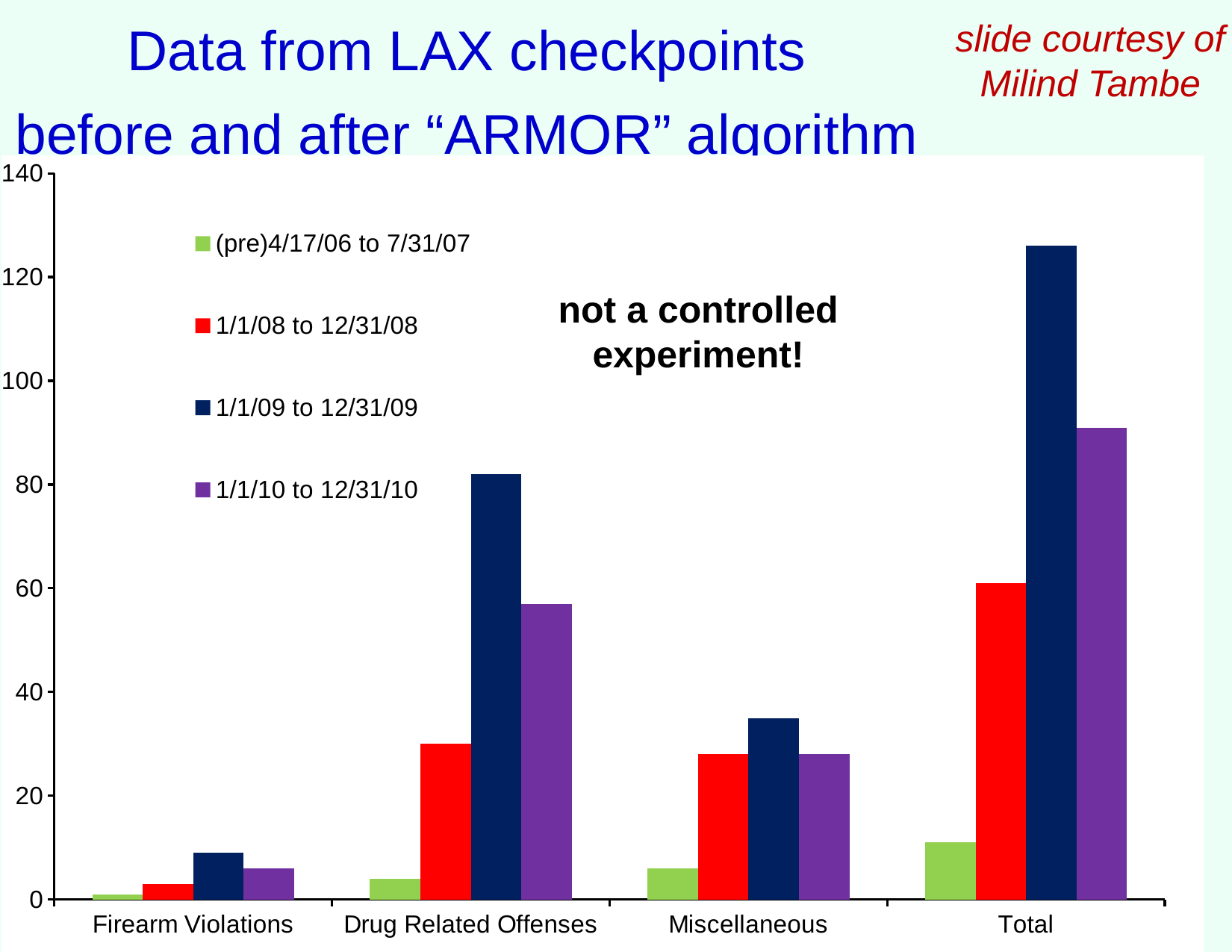
Is the value for Total in the 1/1/09 to 12/31/09 series greater or less than 120? greater Is the value for Firearm Violations in the 1/1/09 to 12/31/09 series greater or less than 20? less For Drug Related Offenses, which series has the larger value: 1/1/09 to 12/31/09 or 1/1/10 to 12/31/10? 1/1/09 to 12/31/09 Which series is shown in red in the legend? 1/1/08 to 12/31/08 What is the title of the slide containing the chart? Data from LAX checkpoints before and after "ARMOR" algorithm Which category has the lowest value for the (pre)4/17/06 to 7/31/07 series? Firearm Violations Is the value for Total in the 1/1/10 to 12/31/10 series greater or less than 80? greater How many series does the legend list? 4 Which category has the highest value for the 1/1/09 to 12/31/09 series? Total How many categories are shown on the x axis? 4 What kind of chart is shown on the slide? bar chart